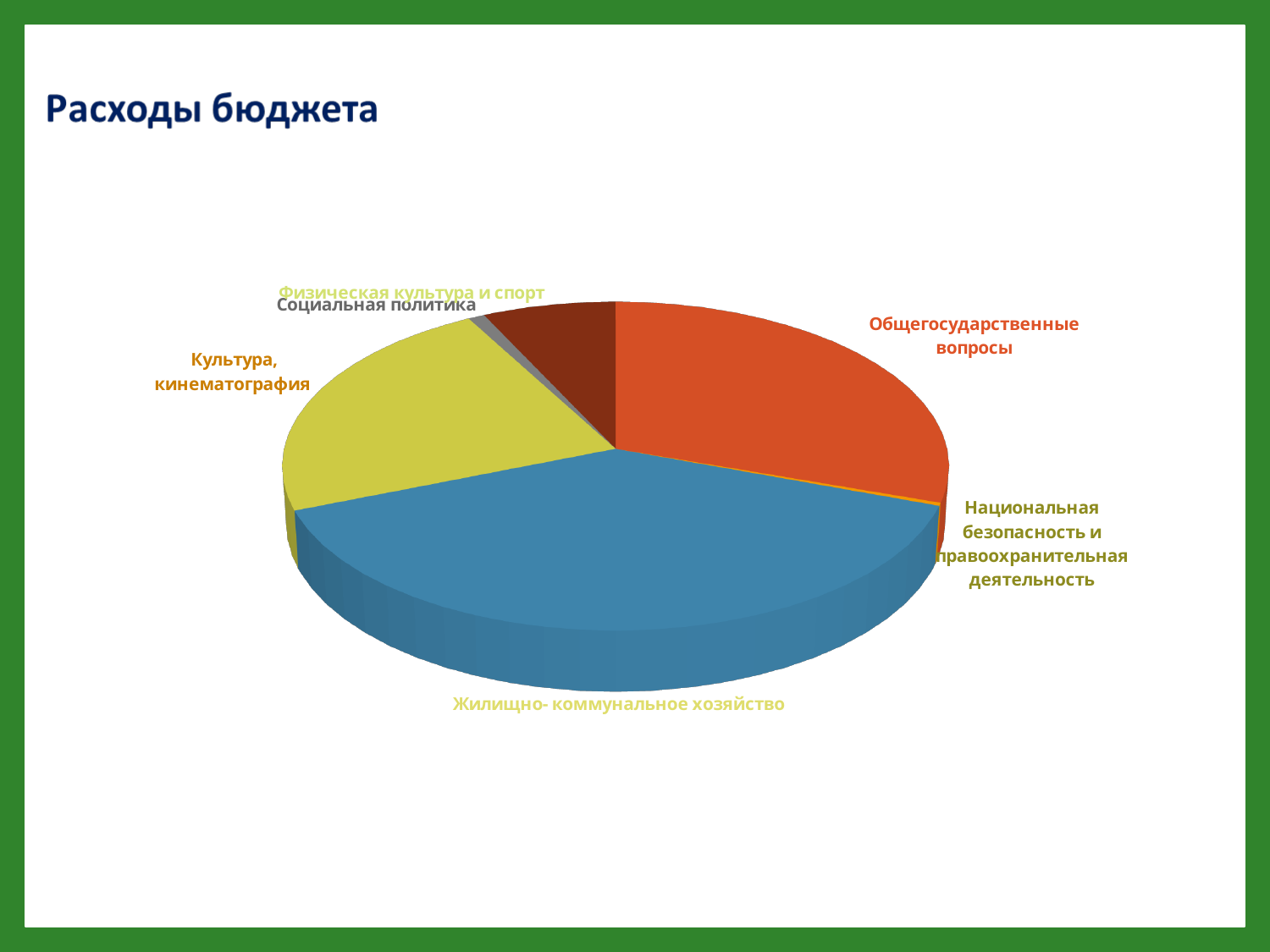
Which slice is larger: Культура, кинематография or Физическая культура и спорт? Культура, кинематография What is the title of the slide with the pie chart? Расходы бюджета Which category has the largest slice of the pie? Жилищно-коммунальное хозяйство Which slice is larger: Жилищно-коммунальное хозяйство or Общегосударственные вопросы? Жилищно-коммунальное хозяйство What colour is the slice for Жилищно-коммунальное хозяйство? Blue What kind of chart is shown on the slide? Pie chart How many categories are labelled on the pie chart? 6 Which slice is larger: Физическая культура и спорт or Социальная политика? Физическая культура и спорт